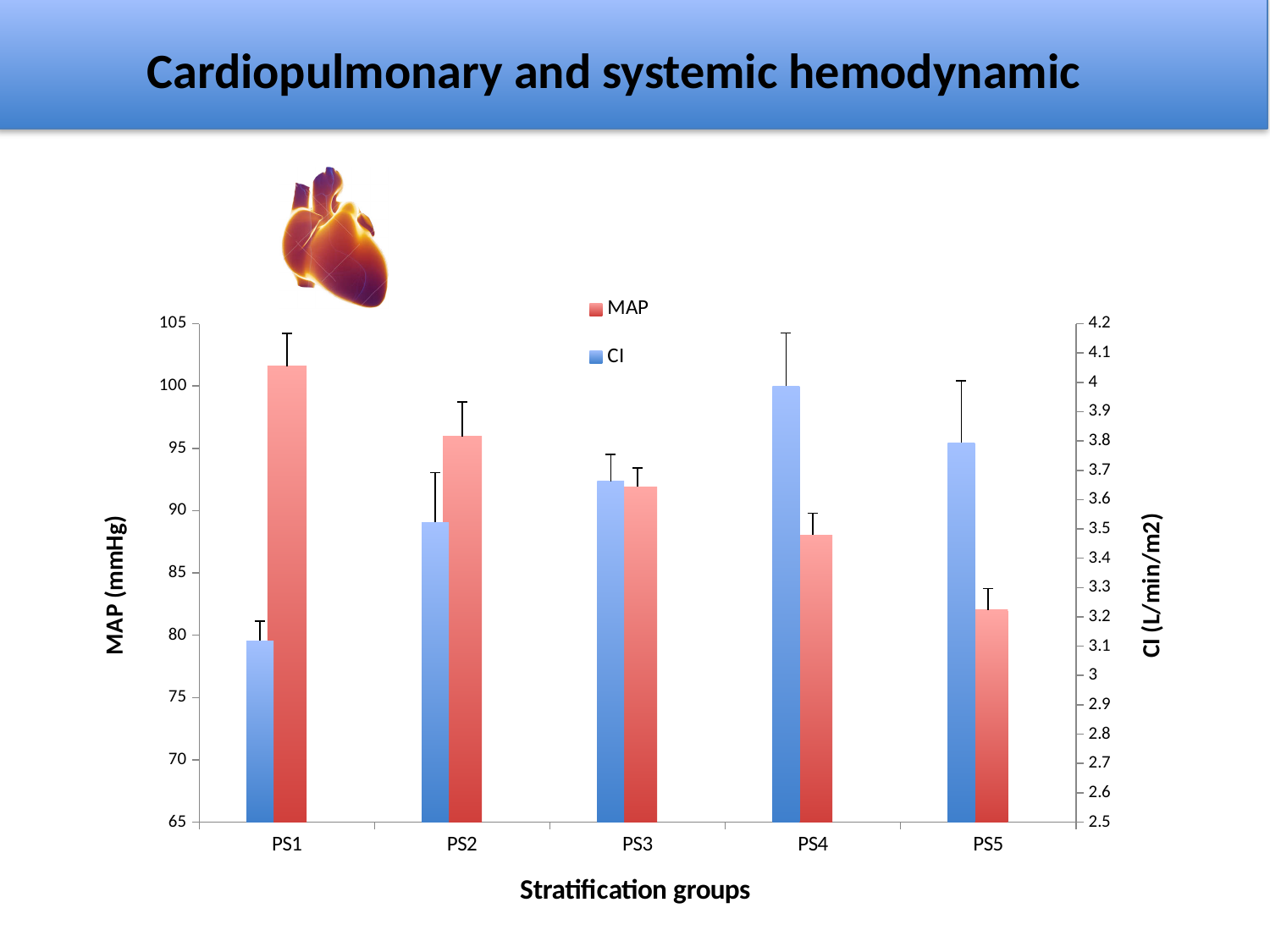
Which stratification group has the highest CI? PS4 Do the MAP values rise or fall from PS1 to PS5? fall How many series does the legend list? 2 Which is larger, the MAP for PS2 or the MAP for PS4? PS2 What is the title of the x axis? Stratification groups Is the CI for PS5 greater or less than 3.5? greater What kind of chart is shown on the slide? Bar chart Which stratification group has the lowest CI? PS1 How many stratification groups are shown on the x axis? 5 Is the MAP for PS5 greater or less than 85? less Which stratification group has the highest MAP? PS1 Which stratification group has the lowest MAP? PS5